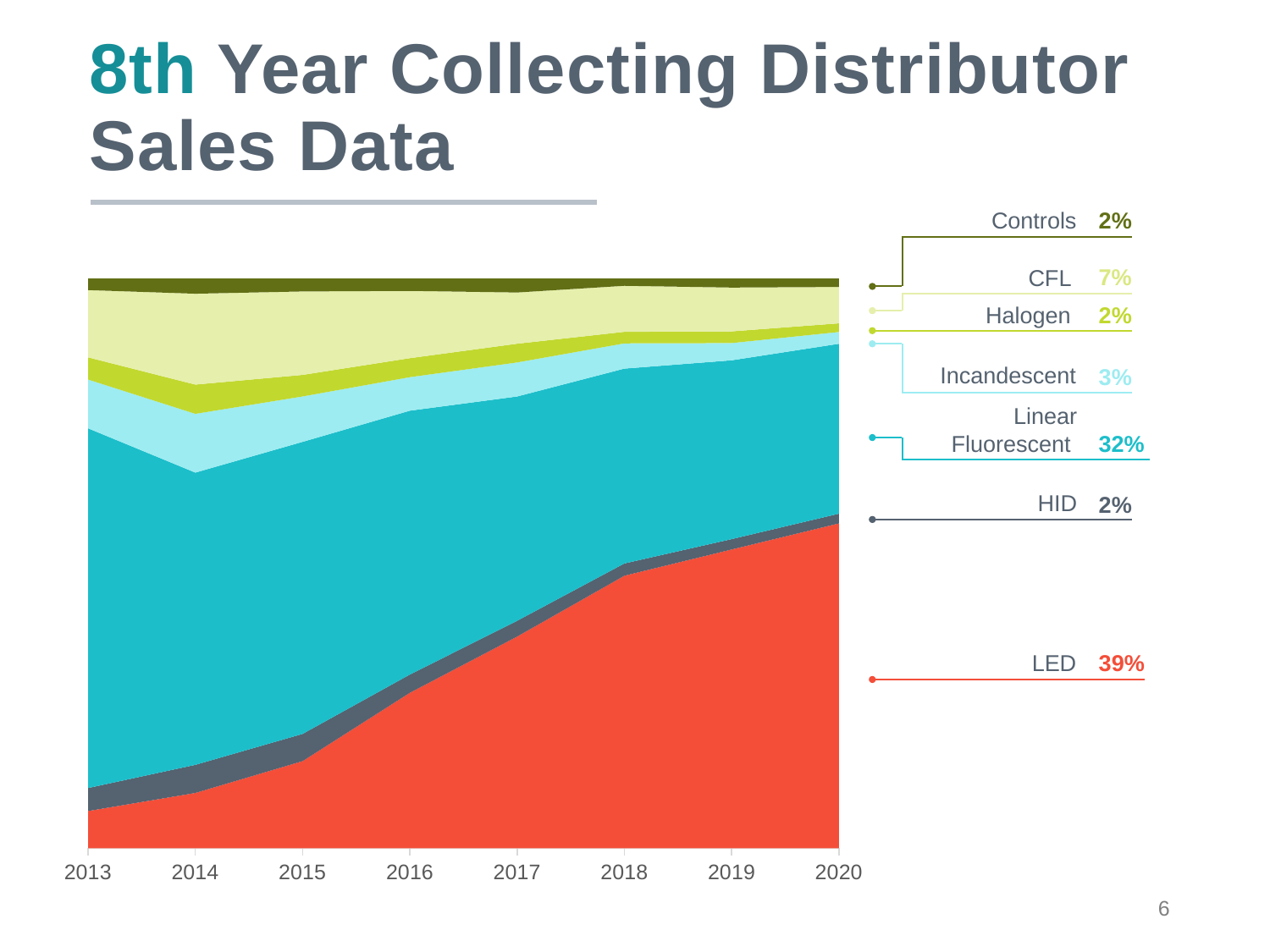
What is the 2020 share shown for Linear Fluorescent? 32% Which has the larger 2020 share, CFL or Incandescent? CFL How many categories are labelled on the right of the chart? 7 What is the 2020 share shown for CFL? 7% Which category has the highest share in 2020? LED What is the 2020 share shown for LED? 39% What kind of chart is shown on the slide? area chart Does the LED area rise or fall from 2013 to 2020? rise What is the combined 2020 share of LED and Linear Fluorescent? 71% What is the difference between the 2020 shares of LED and Linear Fluorescent? 7% How many years are shown on the x axis? 8 What is the 2020 share shown for Incandescent? 3%